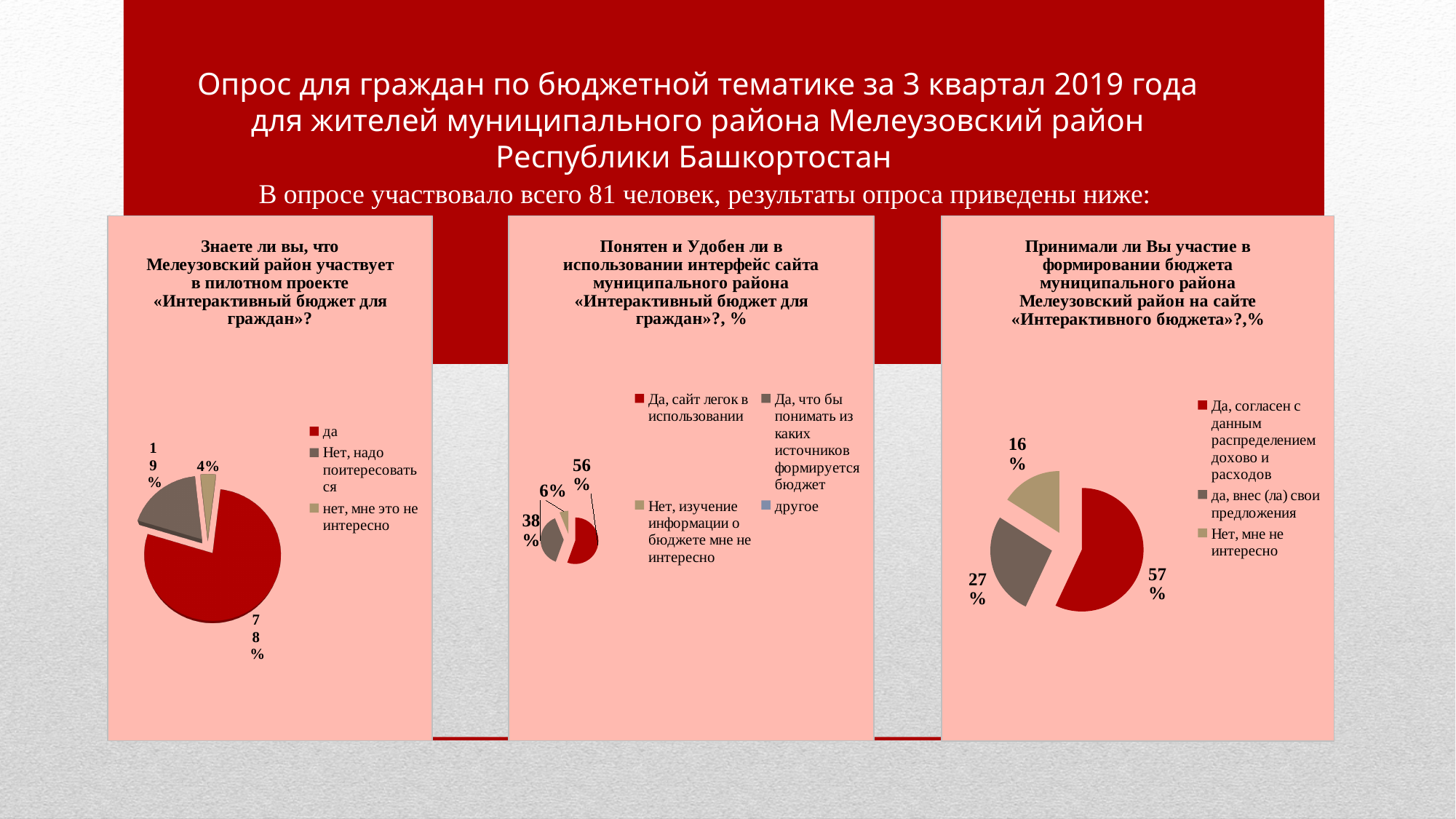
In the middle pie chart, what share of respondents answered "Нет, изучение информации о бюджете мне не интересно"? 6% In the left pie chart, which answer has the smallest share? нет, мне это не интересно In the right pie chart, which is larger: the share for "Да, согласен с данным распределением доходов и расходов" or for "Нет, мне не интересно"? Да, согласен с данным распределением доходов и расходов In the left pie chart, what share of respondents answered "Нет, надо поинтересоваться"? 19% How many entries does the legend of the middle pie chart list? 4 In the middle pie chart, what share of respondents answered "Да, сайт легок в использовании"? 56% In the left pie chart, what is the difference between the shares for "да" and "Нет, надо поинтересоваться"? 59% In the middle pie chart, which answer has the largest share? Да, сайт легок в использовании What type of chart is used on the slide? Pie chart In the right pie chart, what share of respondents answered "да, внес (ла) свои предложения"? 27% In the left pie chart, what share of respondents answered "да"? 78% In the right pie chart, what is the difference between the shares for "да, внес (ла) свои предложения" and "Нет, мне не интересно"? 11%